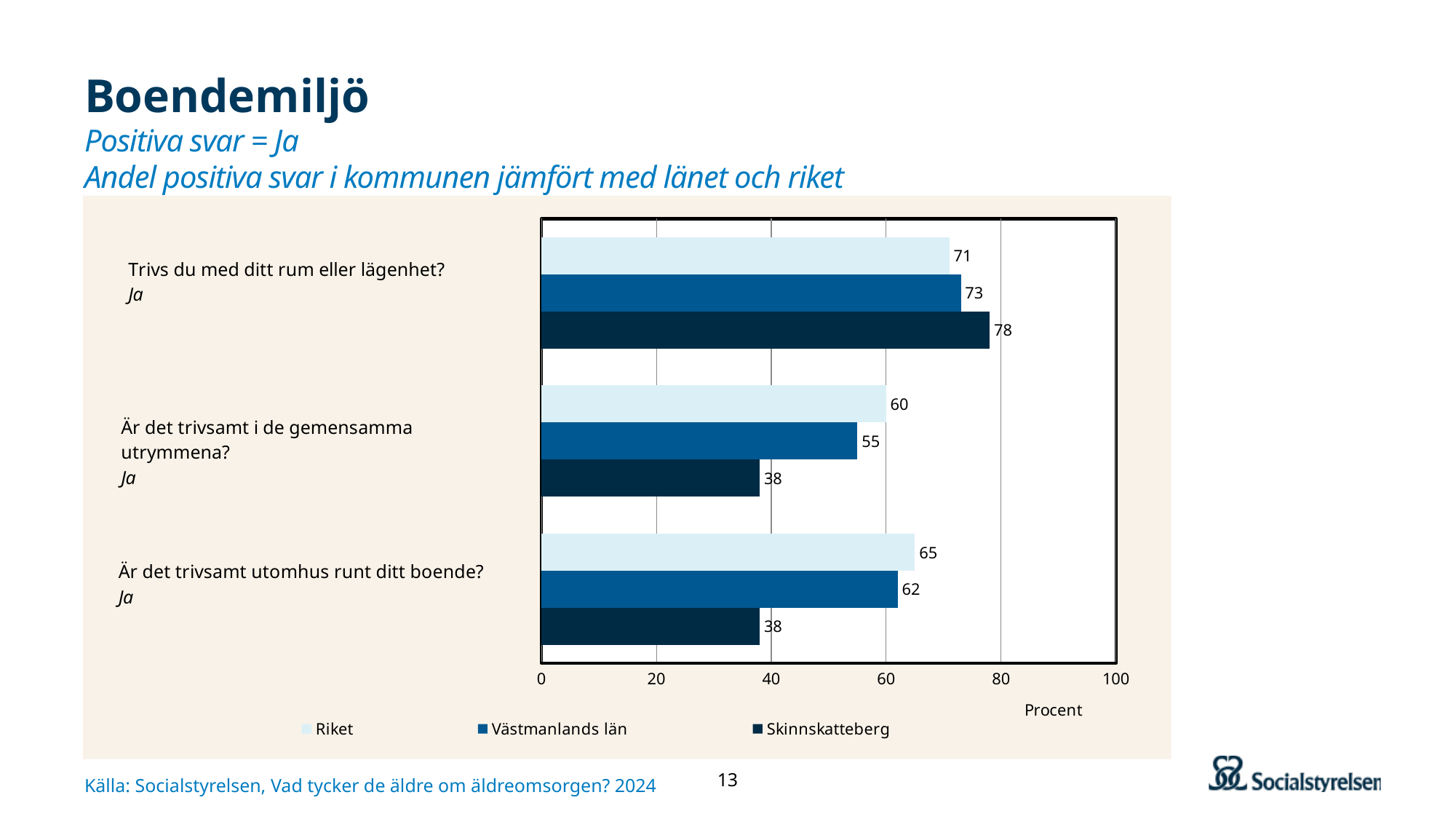
Which series has the highest value for "Trivs du med ditt rum eller lägenhet?"? Skinnskatteberg What kind of chart is shown on the slide? Bar chart Which series has the lowest value for "Är det trivsamt i de gemensamma utrymmena?"? Skinnskatteberg What is the difference between Riket and Skinnskatteberg for "Är det trivsamt utomhus runt ditt boende?"? 27 What is the value for Riket for "Är det trivsamt i de gemensamma utrymmena?"? 60 How many series does the legend list? 3 What is the value for Västmanlands län for "Är det trivsamt utomhus runt ditt boende?"? 62 What is the value for Skinnskatteberg for "Trivs du med ditt rum eller lägenhet?"? 78 What unit is labelled on the horizontal axis of the chart? Procent Is the value for Skinnskatteberg for "Är det trivsamt utomhus runt ditt boende?" greater or less than 40? less Which is larger for "Är det trivsamt i de gemensamma utrymmena?": Riket or Västmanlands län? Riket How many questions (categories) are shown on the chart? 3